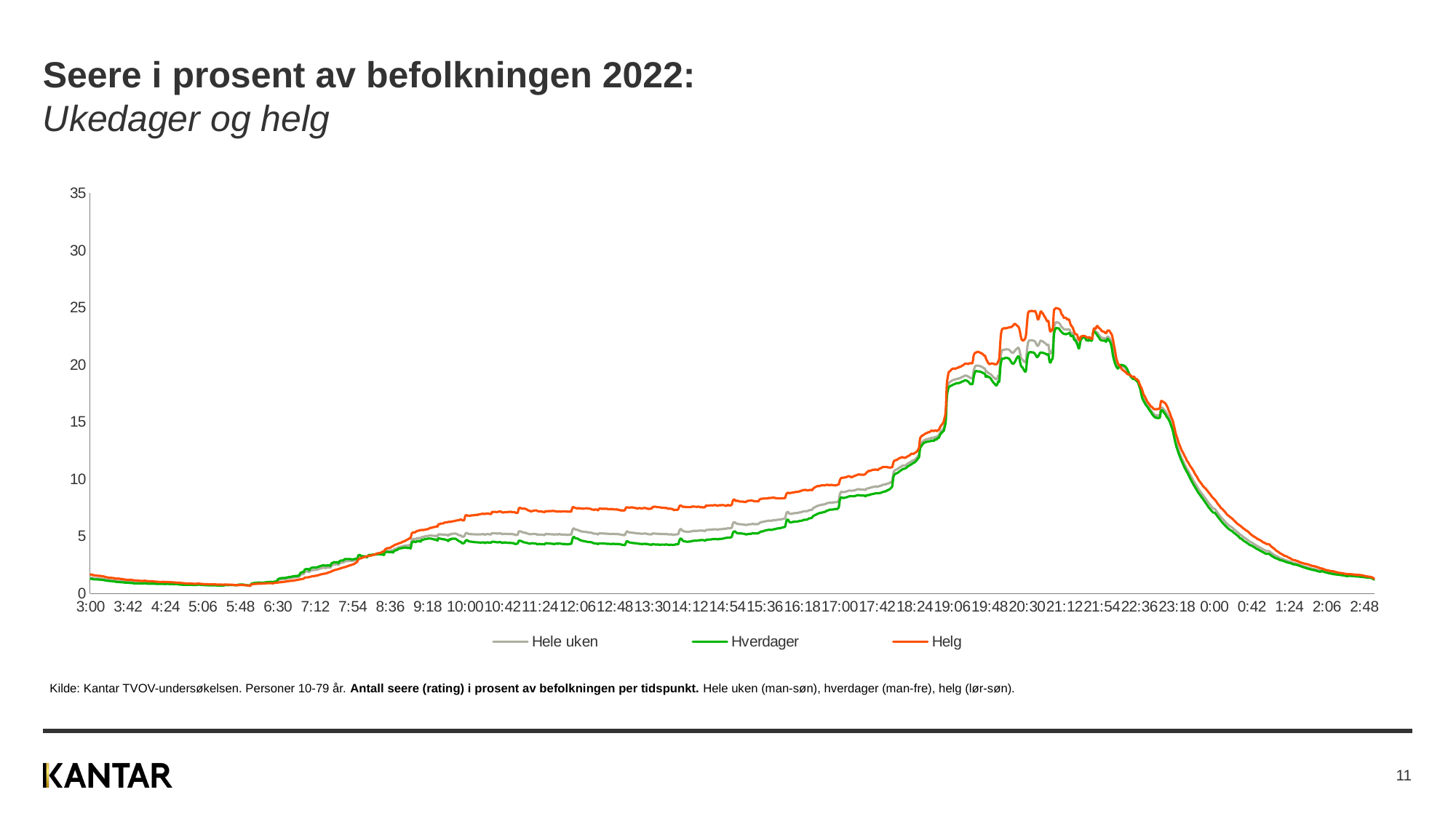
Do the values rise or fall between 18:24 and 20:30? rise What colour is the Helg line? orange What kind of chart is shown on the slide? line chart At 12:06, which is larger: Helg or Hverdager? Helg Is the value for Hele uken at 3:00 greater or less than 5? less Which series reaches the highest peak value? Helg Which series are listed in the legend? Hele uken, Hverdager, Helg Do the values rise or fall between 21:54 and 2:48? fall Is the value for Helg at 12:06 greater or less than 5? greater Is the peak value for Helg greater or less than 20? greater How many series does the legend list? 3